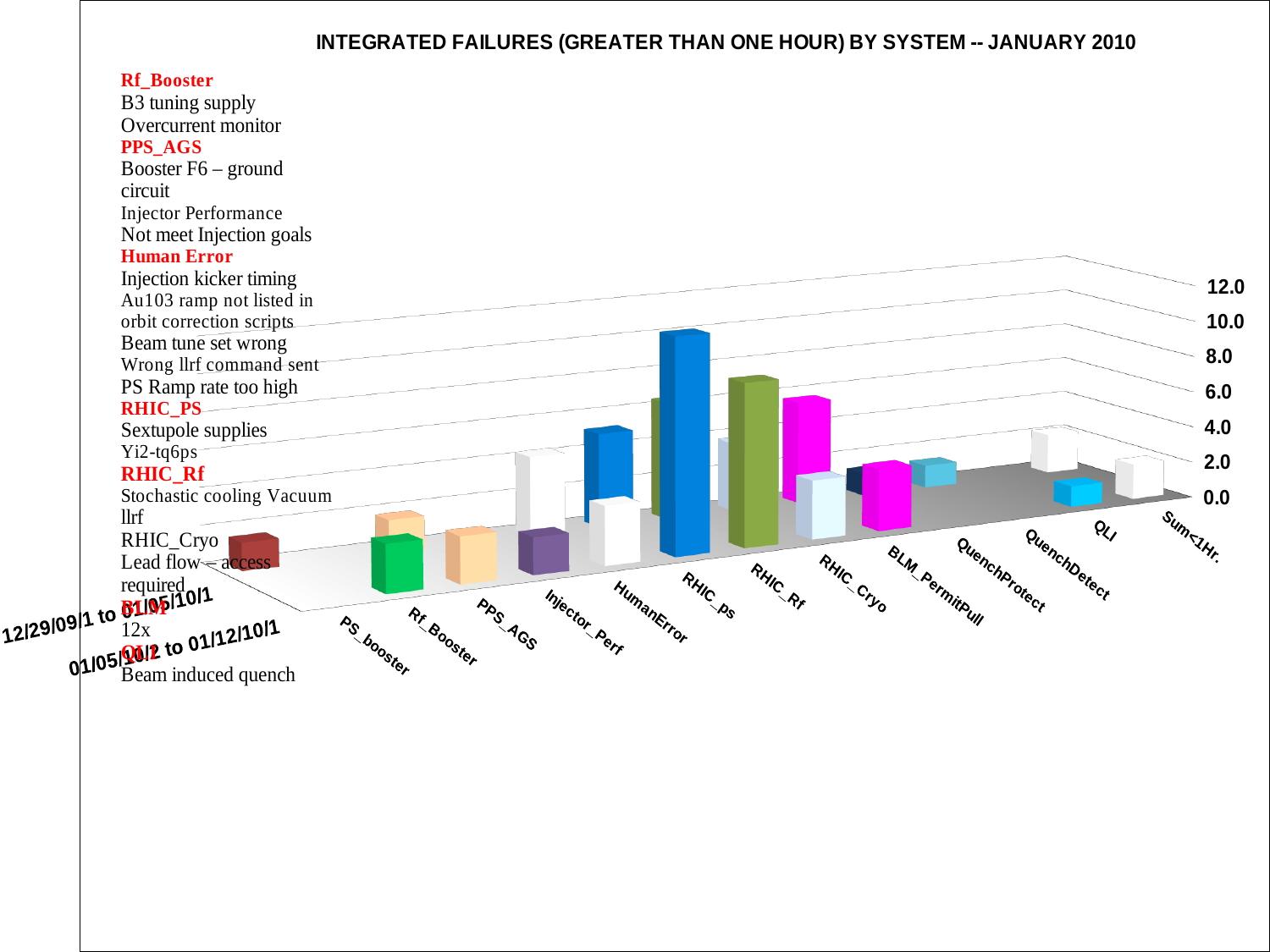
How many series (date ranges) does the chart show? 2 Which has the larger maximum value, HumanError or PS_booster? HumanError Is the tallest bar for HumanError greater or less than 6.0? less What is the highest tick value shown on the vertical axis? 12.0 What is the label of the last category on the x axis? Sum<1Hr. Which system has the tallest bar in the chart? RHIC_ps How many system categories are shown along the x axis of the chart? 13 What kind of chart is shown on the slide? bar chart Are the values for QLI greater or less than 4.0? less Which has the larger maximum value, HumanError or QLI? HumanError Are the values for PS_booster greater or less than 4.0? less What is the title of the chart? INTEGRATED FAILURES (GREATER THAN ONE HOUR) BY SYSTEM -- JANUARY 2010